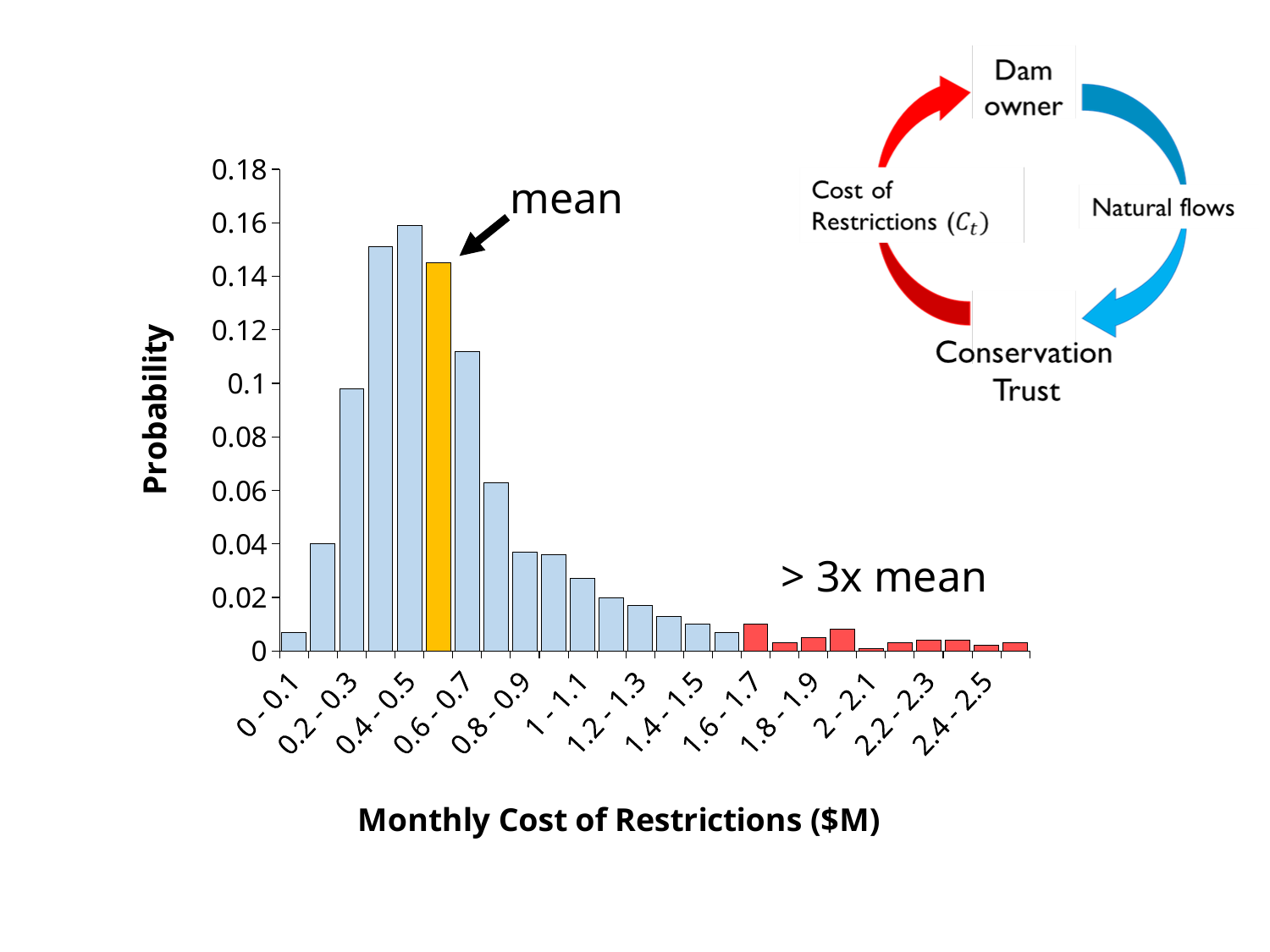
Is the probability for the 0.6 - 0.7 range greater or less than 0.12? less Is the probability for the 1.4 - 1.5 range greater or less than 0.02? less What is the title of the x axis of the chart? Monthly Cost of Restrictions ($M) Is the probability for the 0.2 - 0.3 range greater or less than 0.08? greater Which cost range is highlighted in orange and labelled as the mean? 0.5 - 0.6 Which monthly cost of restrictions range has the highest probability? 0.4 - 0.5 What kind of chart is shown on the slide? bar chart Do the probabilities rise or fall as the monthly cost of restrictions increases beyond the 0.4 - 0.5 range? fall Which monthly cost of restrictions range has the lowest probability? 2 - 2.1 Which has the higher probability, the 0.2 - 0.3 range or the 0.8 - 0.9 range? 0.2 - 0.3